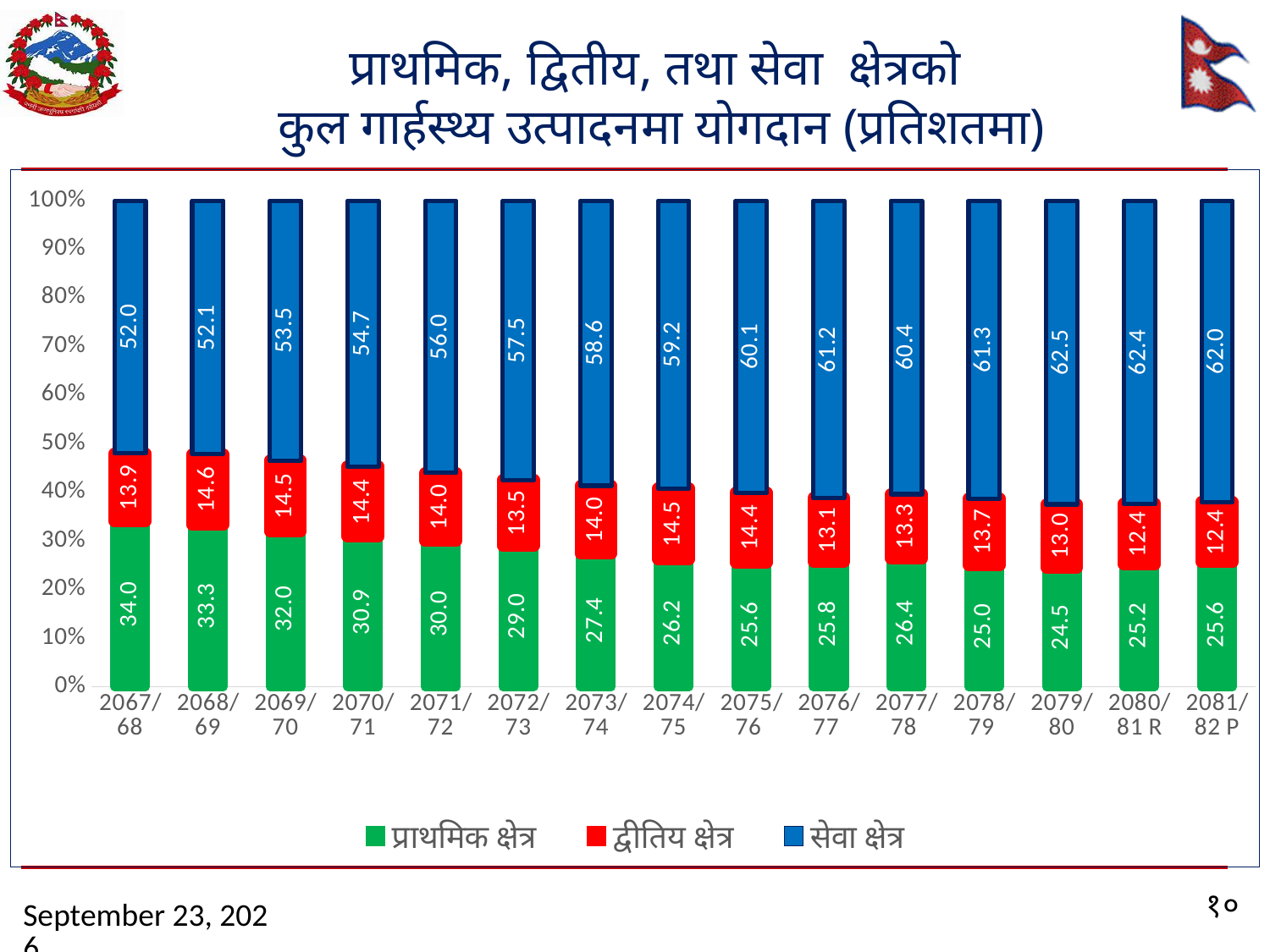
What kind of chart is shown on the slide? Stacked bar chart How many years (categories) are shown on the x axis? 15 Which colour represents द्वीतिय क्षेत्र in the legend? Red What is the value for सेवा क्षेत्र in 2081/82 P? 62.0 Does the सेवा क्षेत्र value generally rise or fall from 2067/68 to 2081/82 P? Rise What is the value for द्वीतिय क्षेत्र in 2068/69? 14.6 In which year is the सेवा क्षेत्र value highest? 2079/80 What is the difference between the सेवा क्षेत्र values in 2081/82 P and 2067/68? 10.0 How many series does the legend list? 3 In which year is the प्राथमिक क्षेत्र value lowest? 2079/80 What is the value for प्राथमिक क्षेत्र in 2067/68? 34.0 Which is larger: the प्राथमिक क्षेत्र value in 2067/68 or in 2081/82 P? 2067/68